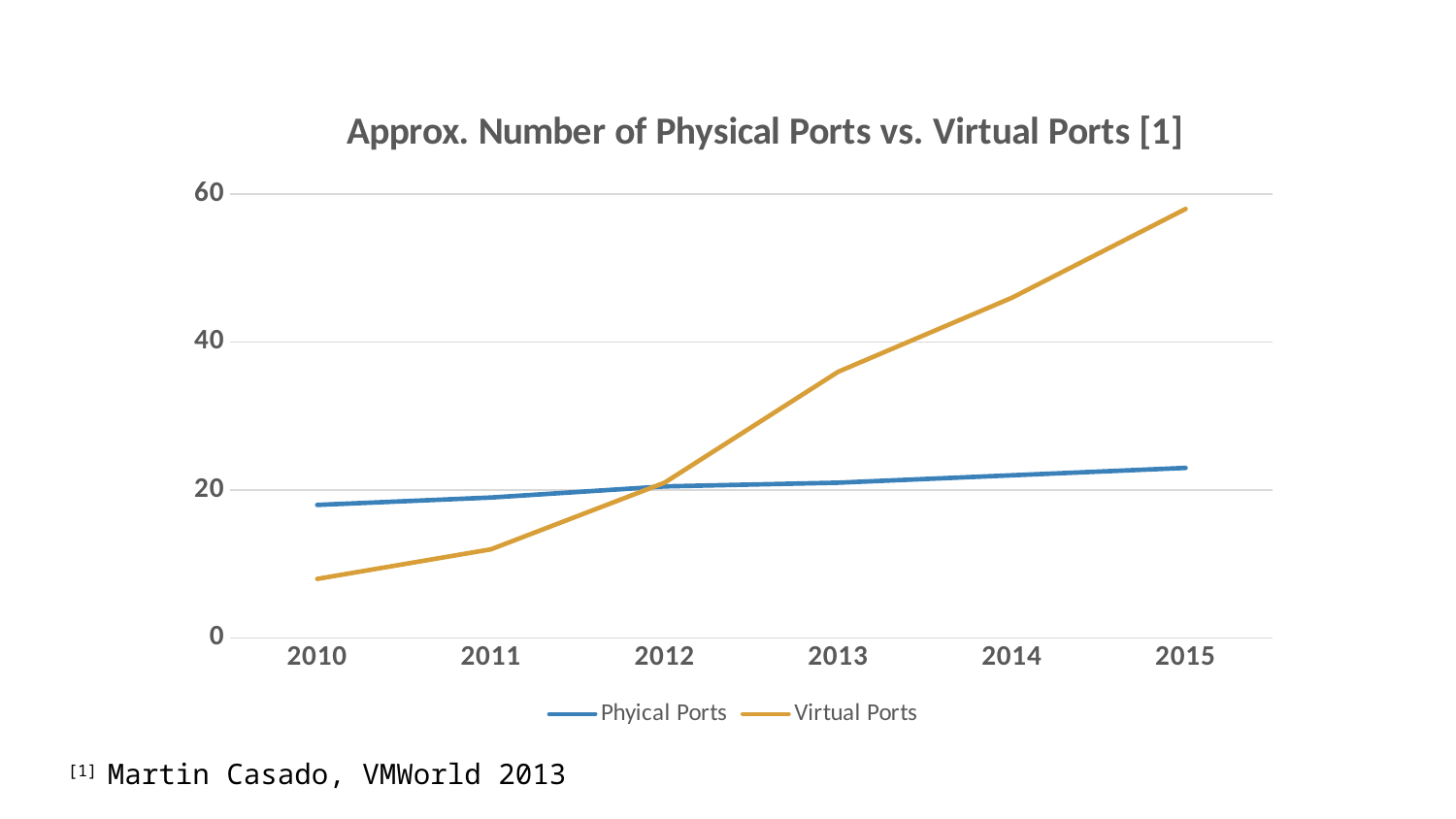
What is the title of the chart? Approx. Number of Physical Ports vs. Virtual Ports [1] Is the value for Virtual Ports in 2015 greater or less than 40? greater In 2015, which series has the larger value, Physical Ports or Virtual Ports? Virtual Ports Do the Virtual Ports values rise or fall from 2010 to 2015? rise Is the value for Physical Ports in 2010 greater or less than 20? less Is the value for Virtual Ports in 2010 greater or less than 20? less What kind of chart is shown on the slide? line chart How many series does the legend list? 2 In which year is the Virtual Ports value highest? 2015 How many years are plotted along the x axis? 6 In 2010, which series has the larger value, Physical Ports or Virtual Ports? Physical Ports